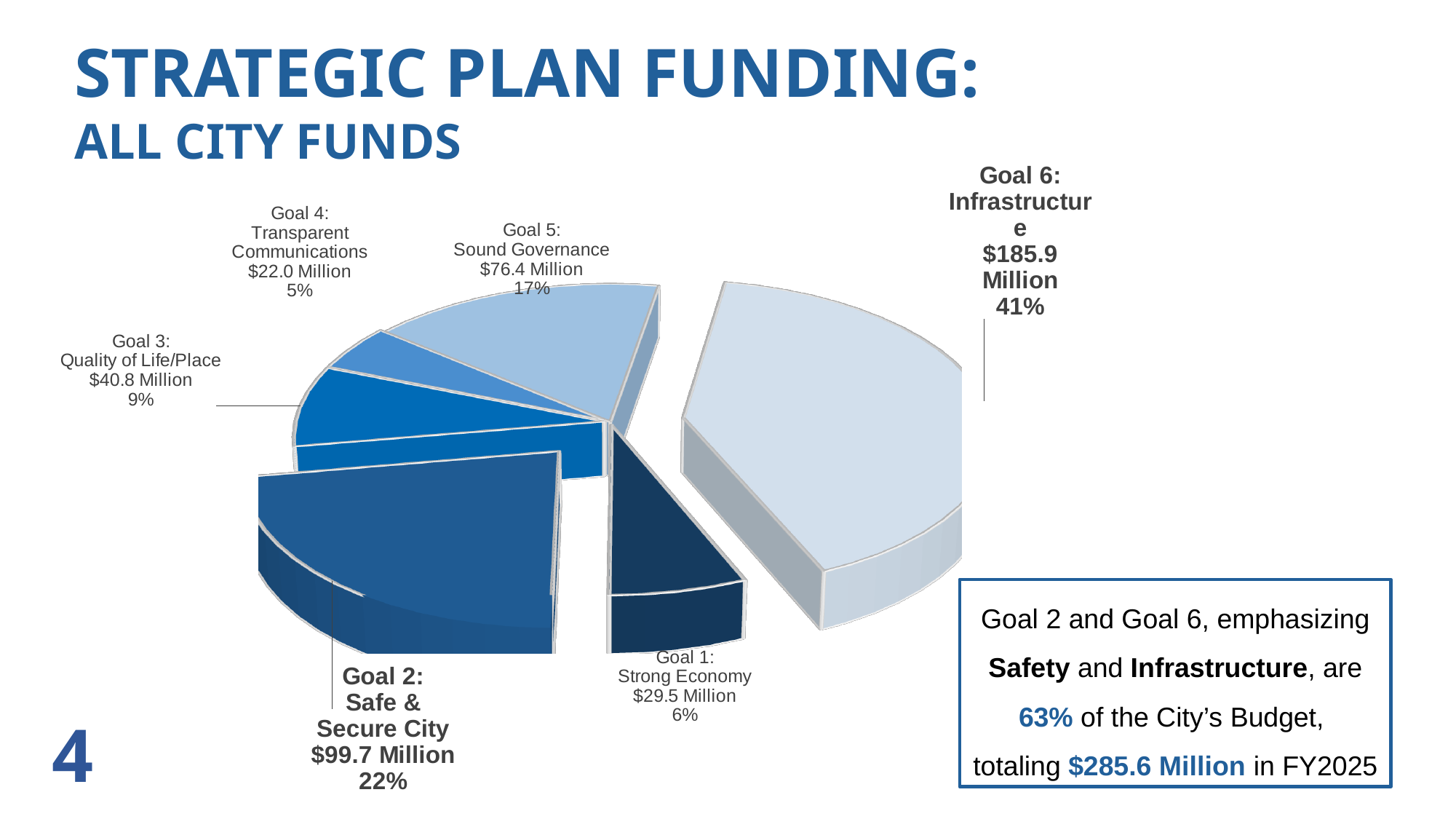
What kind of chart is shown on the slide? Pie chart What is the funding amount for Goal 5: Sound Governance? $76.4 Million Which receives more funding, Goal 1: Strong Economy or Goal 3: Quality of Life/Place? Goal 3: Quality of Life/Place What is the difference in funding between Goal 6: Infrastructure and Goal 2: Safe & Secure City? $86.2 Million What share of the pie does Goal 4: Transparent Communications represent? 5% What is the funding amount for Goal 6: Infrastructure? $185.9 Million Which goal receives the smallest share of funding? Goal 4: Transparent Communications What share of the pie does Goal 3: Quality of Life/Place represent? 9% Which goal receives the largest share of funding? Goal 6: Infrastructure What is the funding amount for Goal 2: Safe & Secure City? $99.7 Million How many slices does the pie chart have? 6 What is the title of the slide containing the pie chart? Strategic Plan Funding: All City Funds